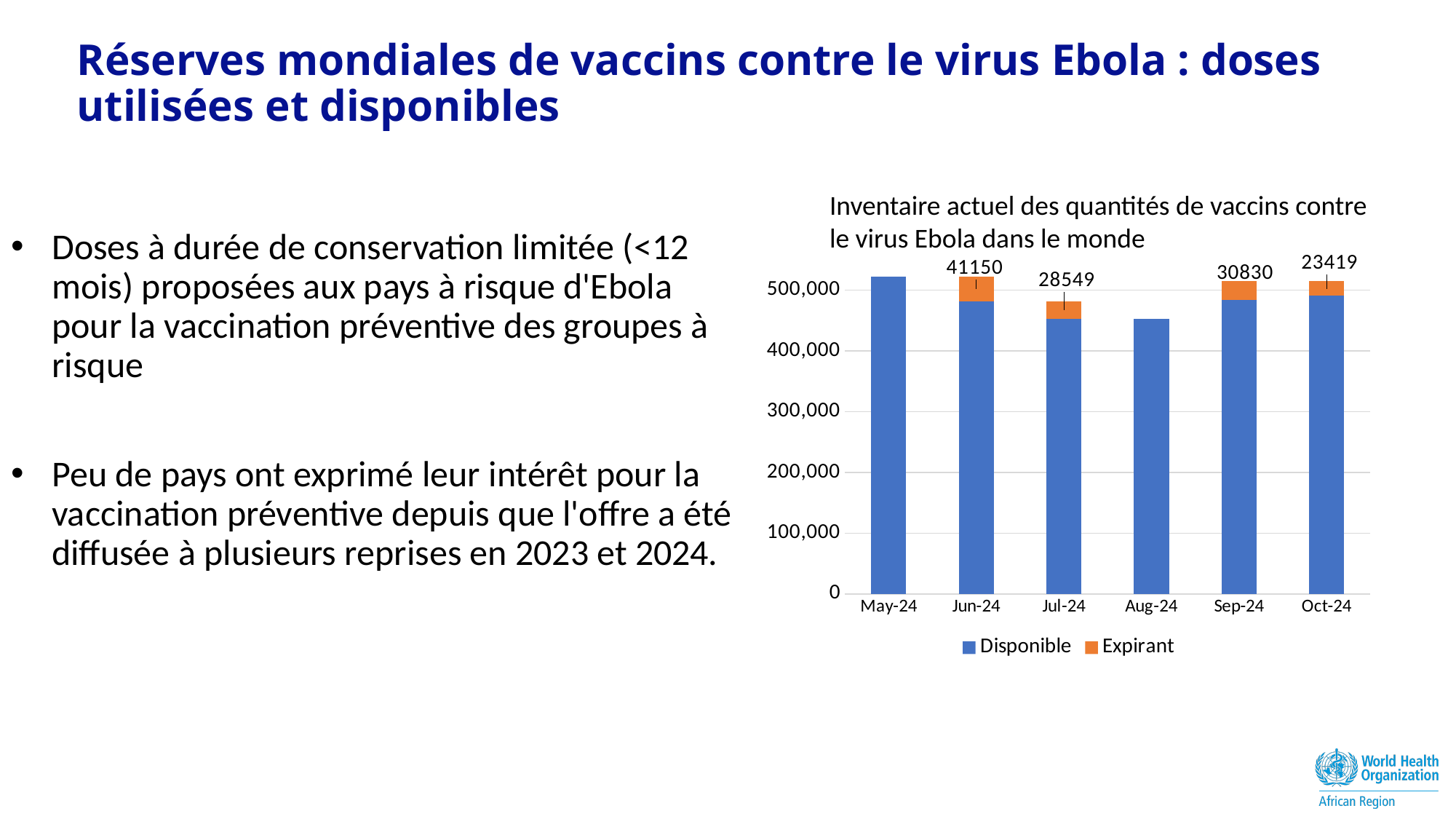
What is the difference between the Expirant values for Jun-24 and Jul-24? 12601 What is the Expirant value for Jun-24? 41150 What is the Expirant value for Jul-24? 28549 Among the months with an Expirant label, which has the lowest Expirant value? Oct-24 Is the Disponible value for Aug-24 greater or less than 500,000? less Is the Disponible value for May-24 greater or less than 500,000? greater Which month has the highest Expirant value? Jun-24 How many series does the legend list? 2 How many months are shown on the x axis? 6 What kind of chart is shown on the slide? Stacked bar chart What is the Expirant value for Oct-24? 23419 Which is larger, the Expirant value for Jul-24 or for Sep-24? Sep-24